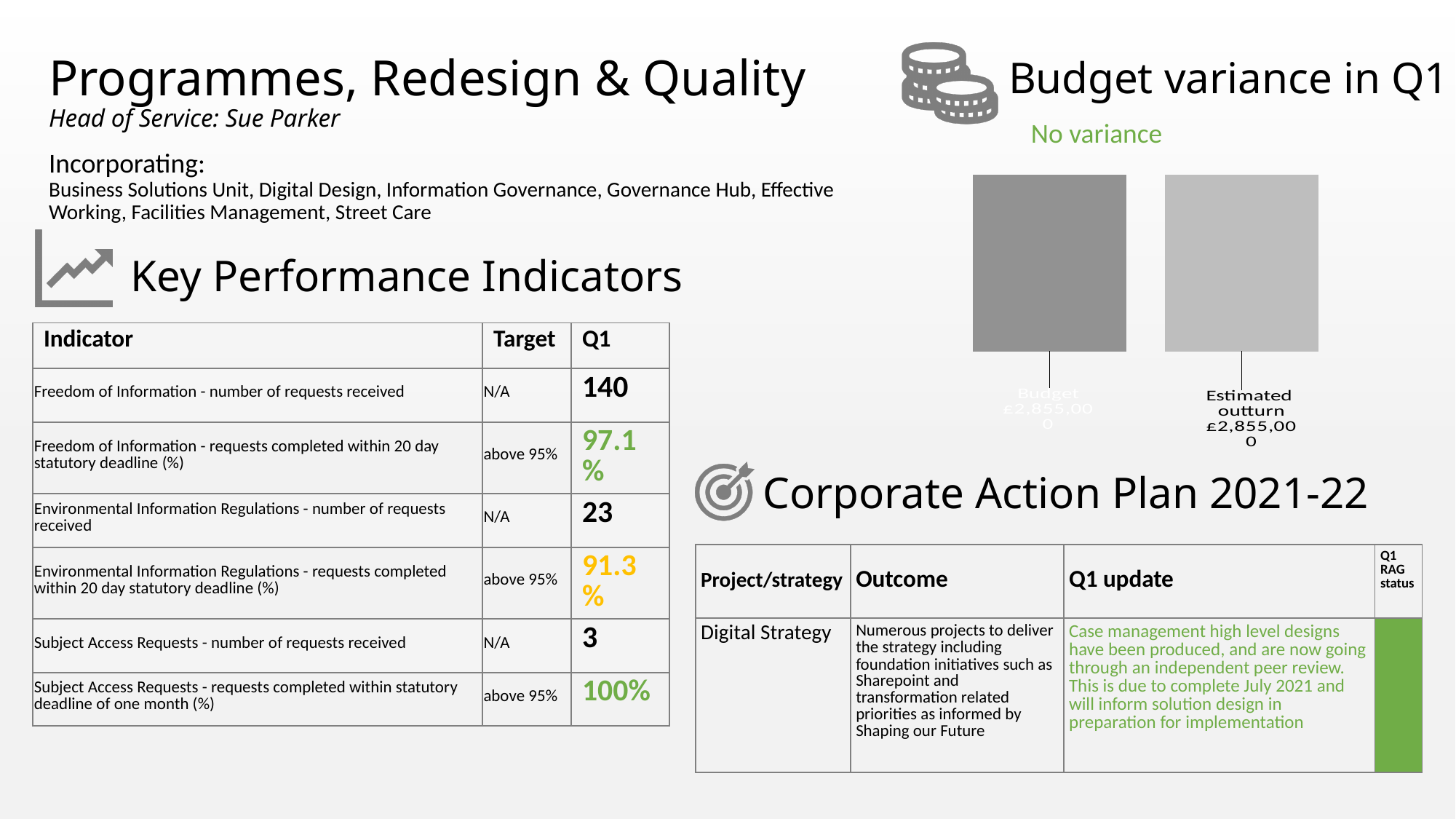
In the 'Budget variance in Q1' chart, what is the value labelled for Estimated outturn? £2,855,000 What are the two categories shown in the 'Budget variance in Q1' chart? Budget and Estimated outturn What is the title of the chart on the right-hand side of the slide? Budget variance in Q1 In the 'Budget variance in Q1' chart, which bar is drawn in the darker grey, Budget or Estimated outturn? Budget What kind of chart is shown under the 'Budget variance in Q1' heading? bar chart How many bars does the 'Budget variance in Q1' chart show? 2